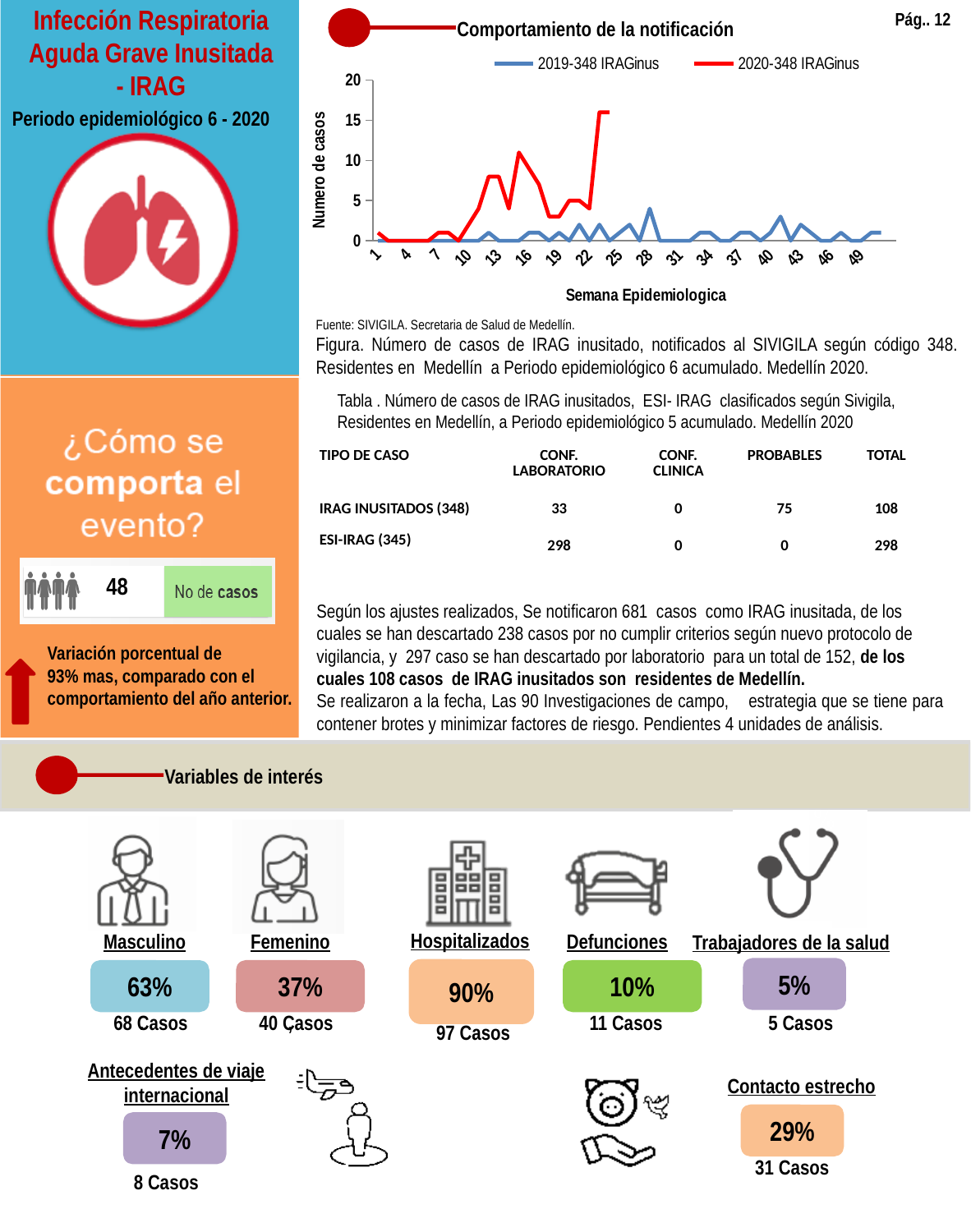
How many series does the legend of the 'Comportamiento de la notificación' chart list? 2 In the 'Comportamiento de la notificación' chart, is the value of the 2020-348 IRAGinus series at week 16 greater or less than 5? greater What are the two series named in the legend of the 'Comportamiento de la notificación' chart? 2019-348 IRAGinus and 2020-348 IRAGinus In the 'Comportamiento de la notificación' chart, does the 2020-348 IRAGinus series generally rise or fall between week 7 and week 24? rise In the 'Comportamiento de la notificación' chart, is the highest value of the 2019-348 IRAGinus series greater or less than 10? less What is the highest tick value shown on the vertical axis of the 'Comportamiento de la notificación' chart? 20 What is the label of the vertical axis in the 'Comportamiento de la notificación' chart? Numero de casos In the 'Comportamiento de la notificación' chart, which series reaches the highest peak, 2019-348 IRAGinus or 2020-348 IRAGinus? 2020-348 IRAGinus In the 'Comportamiento de la notificación' chart, is the value of the 2019-348 IRAGinus series at week 16 greater or less than 5? less In the 'Comportamiento de la notificación' chart, which series extends across all weeks up to week 49? 2019-348 IRAGinus What kind of chart is 'Comportamiento de la notificación'? line chart